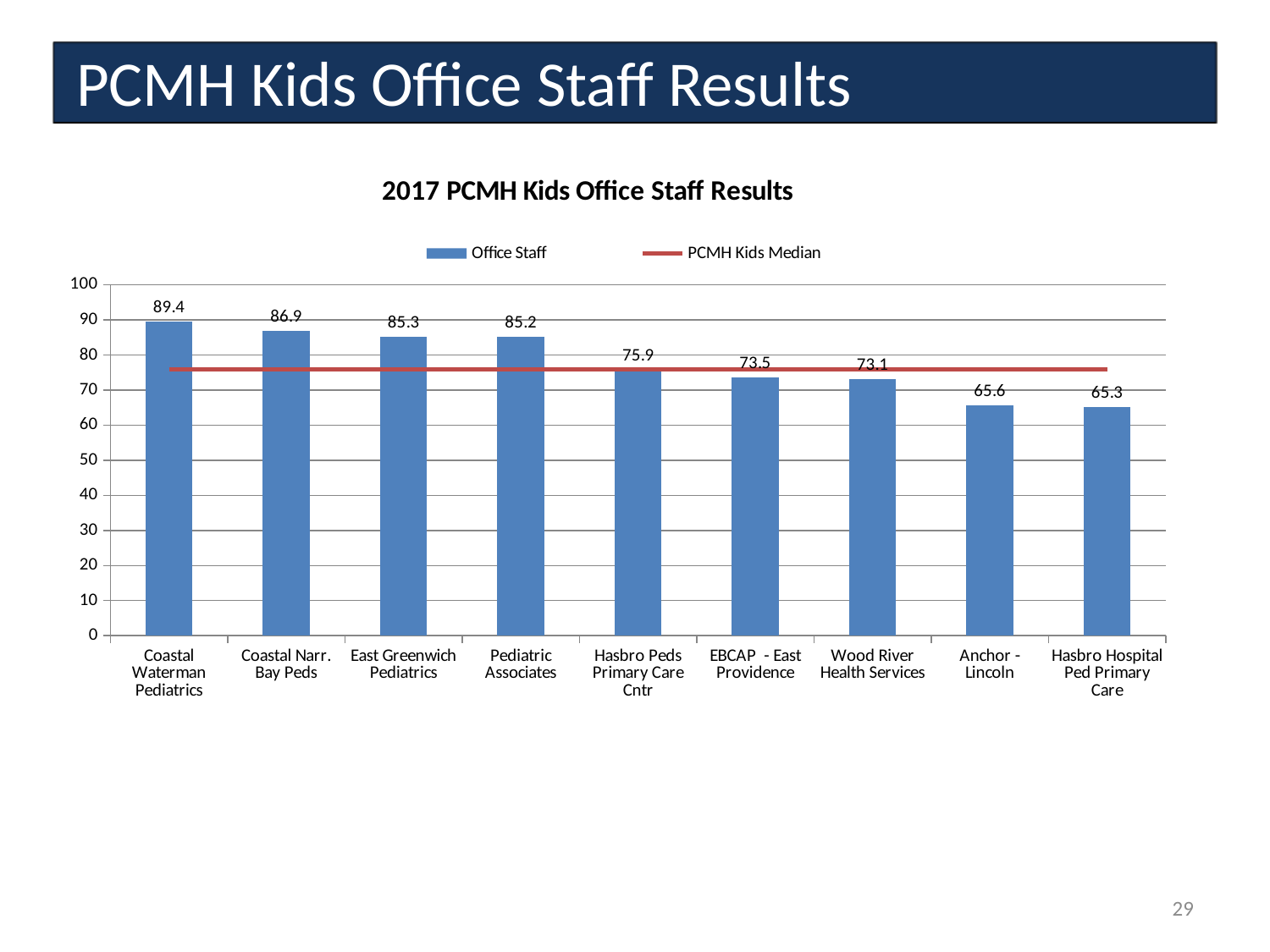
Which practice has the lowest Office Staff value? Hasbro Hospital Ped Primary Care How many series does the legend list? 2 Is the PCMH Kids Median line greater or less than 80? less How many practices are shown on the x axis? 9 What is the Office Staff value for Wood River Health Services? 73.1 Which practice has the highest Office Staff value? Coastal Waterman Pediatrics What is the difference between the Office Staff values for Coastal Waterman Pediatrics and Anchor - Lincoln? 23.8 What is the Office Staff value for Coastal Waterman Pediatrics? 89.4 What kind of chart is shown on the slide? Combination bar and line chart What is the title of the chart? 2017 PCMH Kids Office Staff Results Which has a higher Office Staff value, Coastal Narr. Bay Peds or EBCAP - East Providence? Coastal Narr. Bay Peds What is the Office Staff value for Hasbro Peds Primary Care Cntr? 75.9